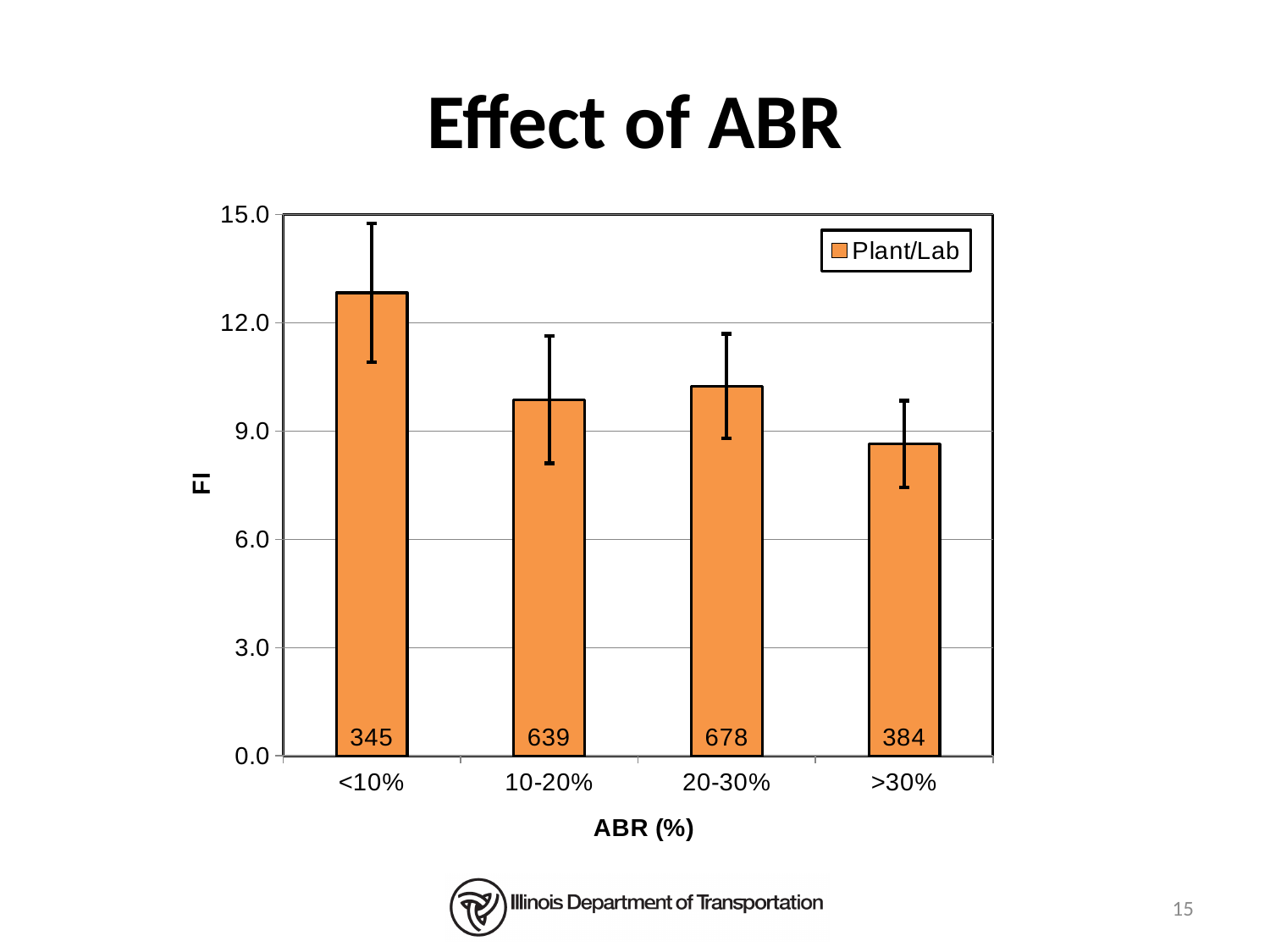
What is the title of the chart? Effect of ABR What is the name of the series in the legend? Plant/Lab Which ABR category has the highest FI? <10% What number is printed at the base of the bar for 20-30%? 678 How many ABR categories are shown on the x axis? 4 Which has a larger FI, <10% or 10-20%? <10% Which ABR category has the lowest FI? >30% Is the FI value for 10-20% greater or less than 9.0? greater How many series does the legend list? 1 Is the FI value for <10% greater or less than 12.0? greater Is the FI value for >30% greater or less than 9.0? less What kind of chart is shown on the slide? bar chart